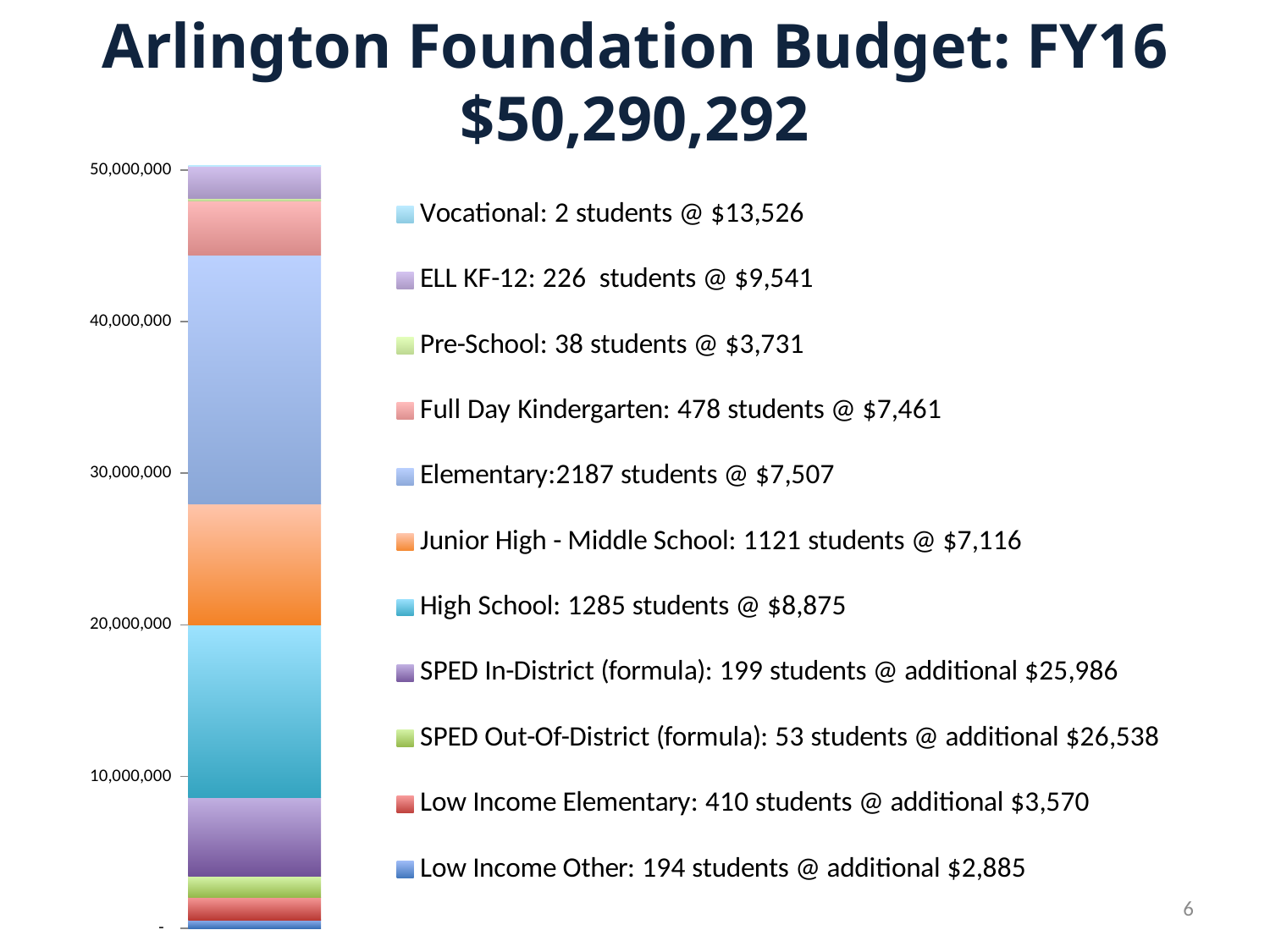
What is the total of the stacked bar, as given in the slide title? $50,290,292 Is the Junior High - Middle School segment greater or less than 10,000,000? less What kind of chart is shown on the slide? stacked bar chart Is the Elementary segment greater or less than 10,000,000? greater How many series does the legend list? 11 Which segment of the stacked bar is the largest? Elementary What is the highest value shown on the vertical axis? 50,000,000 According to the legend, how many students are in the Elementary category? 2187 Which is larger, the Elementary segment or the High School segment? Elementary How many bars are plotted in the chart? 1 Which is larger, the Junior High - Middle School segment or the Full Day Kindergarten segment? Junior High - Middle School